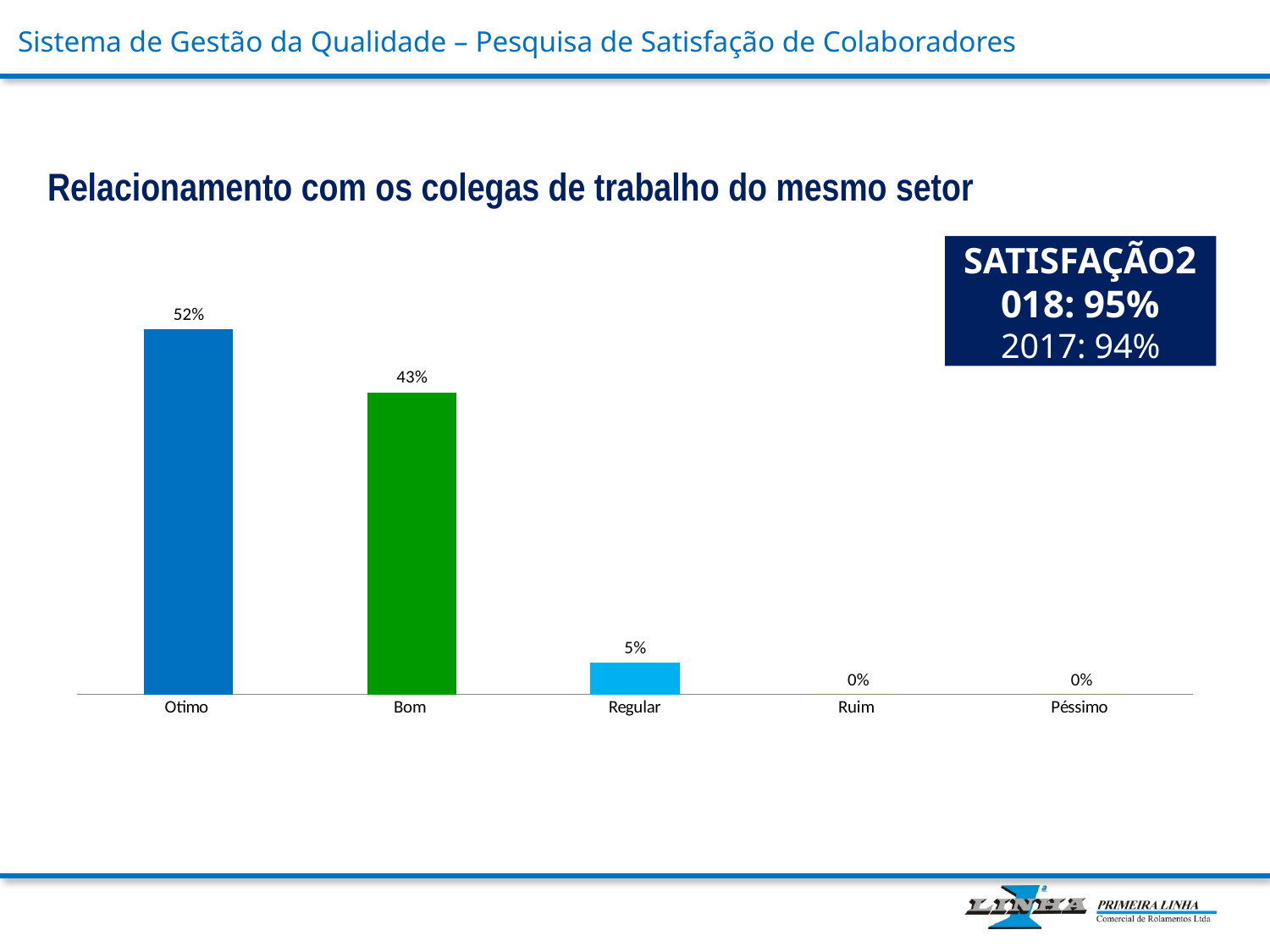
What colour is the bar for Bom? Green Do the values rise or fall from Otimo to Péssimo along the x axis? Fall Which category has the highest value? Otimo Which is larger, the value for Bom or the value for Regular? Bom What is the value for Bom? 43% What is the combined value of Otimo and Bom? 95% What is the value for Otimo? 52% What kind of chart is shown on the slide? Bar chart What is the value for Ruim? 0% What is the difference between the values for Otimo and Bom? 9% How many categories are shown on the x axis? 5 What is the value for Regular? 5%